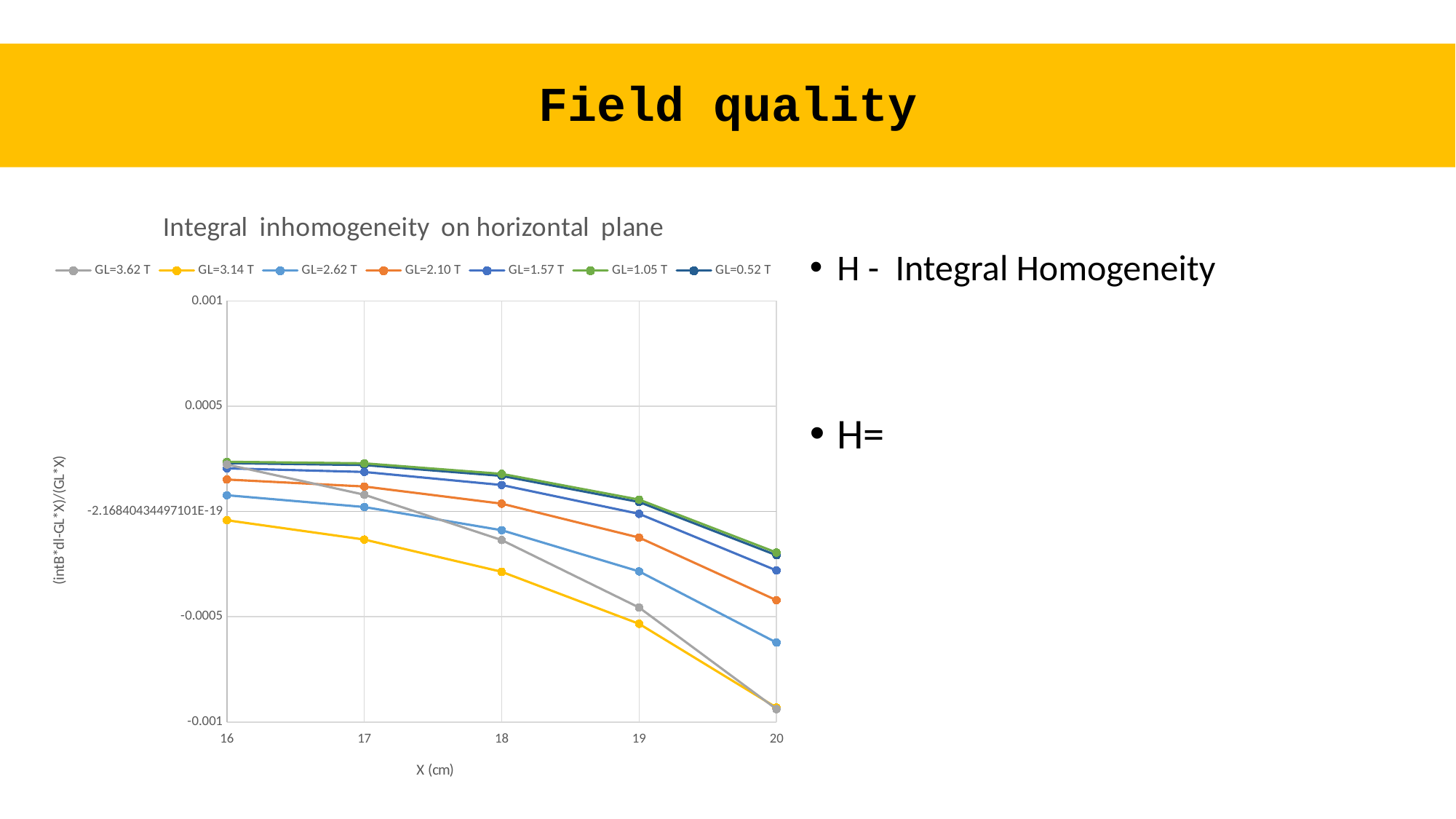
Do the values of the GL=3.62 T series rise or fall as X increases from 16 to 20? fall How many X (cm) points are plotted for each series? 5 Is the value for GL=2.10 T at X=20 greater or less than -0.0005? greater How many series does the legend of the chart list? 7 Which series has the lowest value at X=16? GL=3.14 T Is the value for GL=3.62 T at X=20 greater or less than -0.0005? less Is the value for GL=2.62 T at X=20 greater or less than -0.0005? less What is the label of the x axis? X (cm) What is the title of the chart? Integral inhomogeneity on horizontal plane What kind of chart is shown on the slide? line chart At X=20, which is larger: the value for GL=1.05 T or the value for GL=3.14 T? GL=1.05 T Do the values of the GL=1.05 T series rise or fall as X increases from 16 to 20? fall